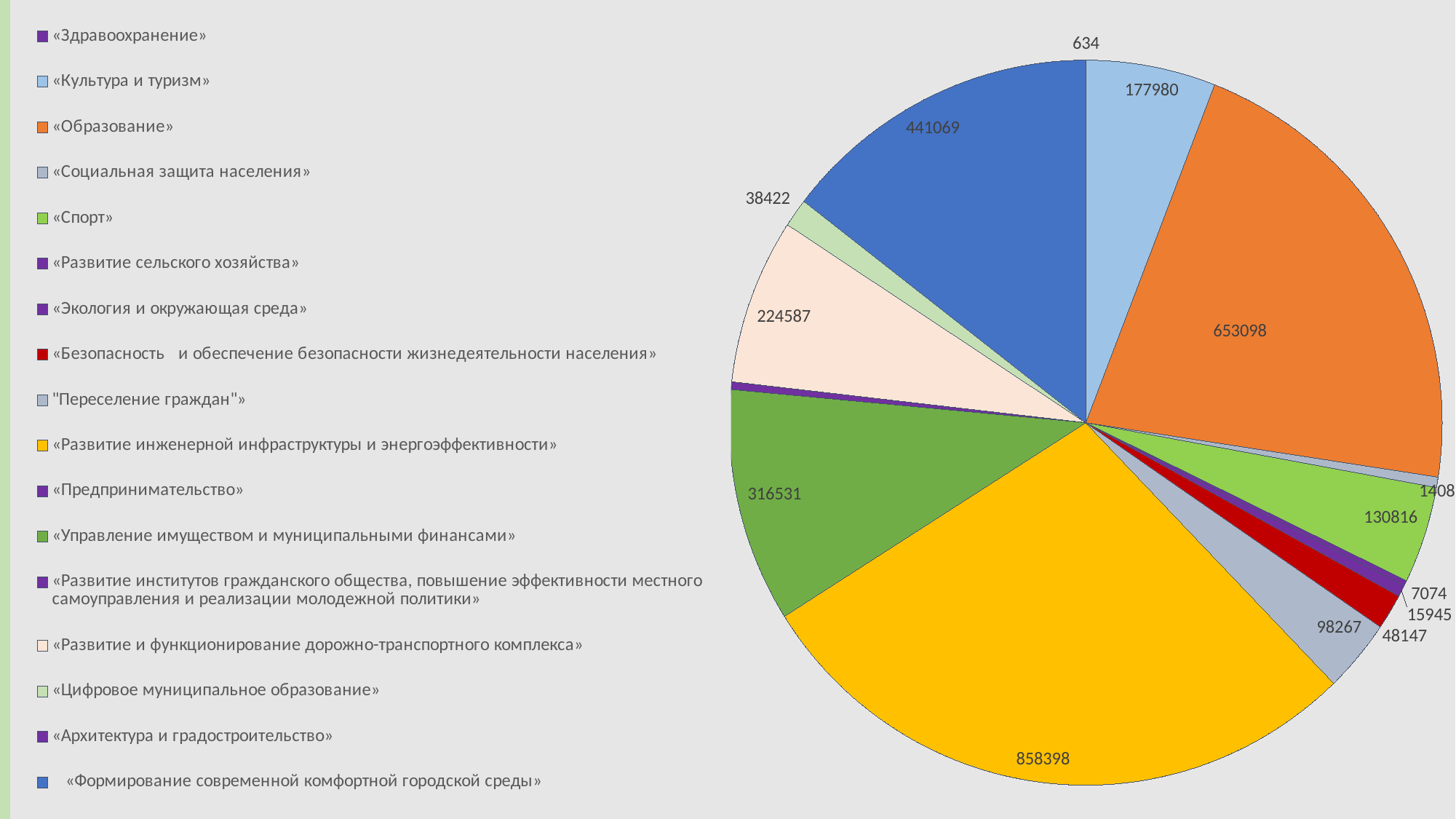
How many categories does the legend list? 17 Which category has the largest slice of the pie? «Развитие инженерной инфраструктуры и энергоэффективности» What is the value for «Развитие и функционирование дорожно-транспортного комплекса»? 224587 What is the value for «Культура и туризм»? 177980 What is the value for «Спорт»? 130816 What is the value for «Управление имуществом и муниципальными финансами»? 316531 Which is larger, the value for «Образование» or the value for «Формирование современной комфортной городской среды»? «Образование» What is the value for «Развитие инженерной инфраструктуры и энергоэффективности»? 858398 What kind of chart is shown on the slide? pie chart What is the difference between the values for «Развитие инженерной инфраструктуры и энергоэффективности» and «Образование»? 205300 What is the value for «Образование»? 653098 What is the value for «Формирование современной комфортной городской среды»? 441069